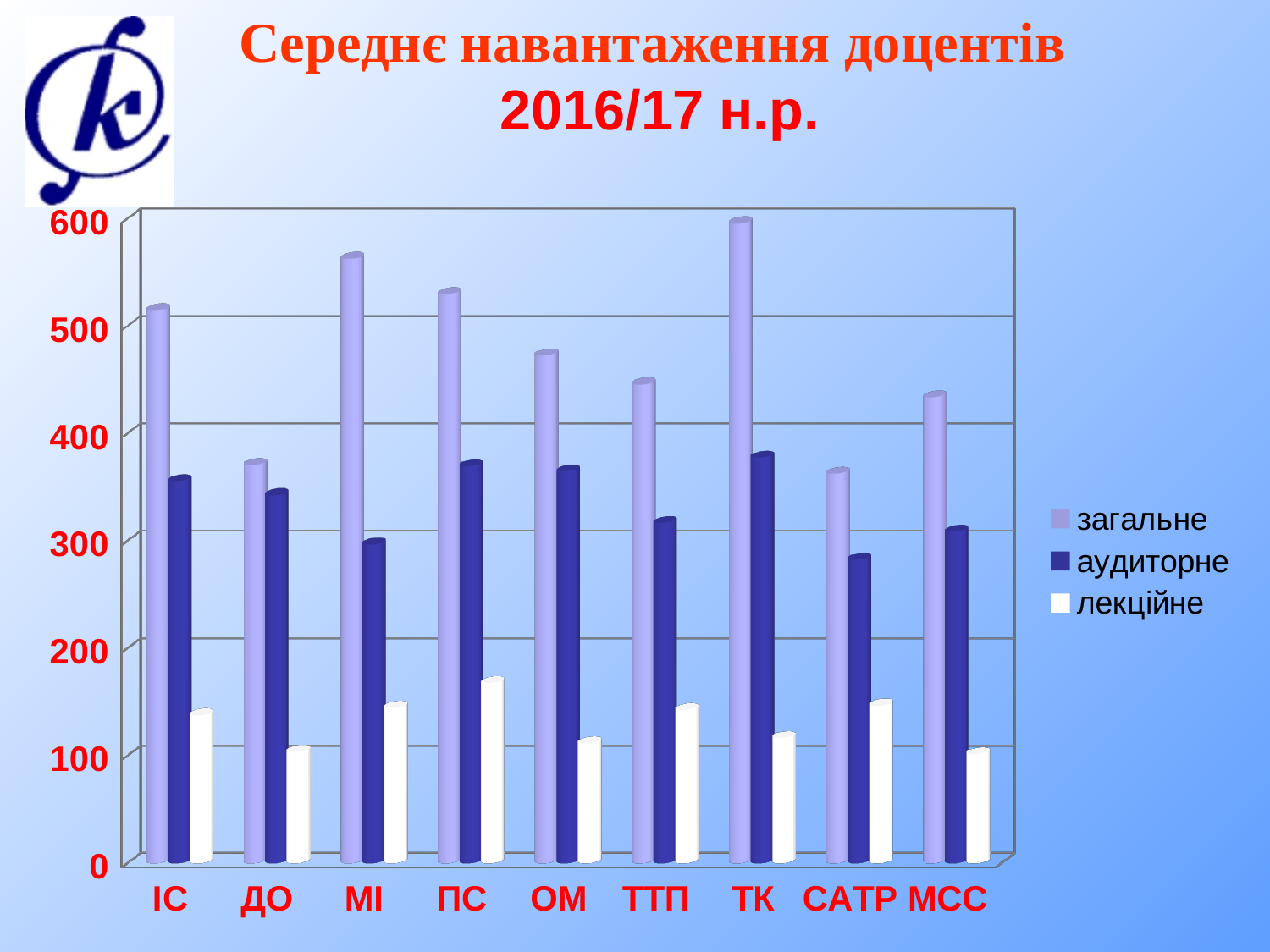
Which category has the highest value for загальне? ТК Which is larger, the загальне value for МІ or for ПС? МІ What is the title of the chart? Середнє навантаження доцентів 2016/17 н.р. How many series does the legend list? 3 Is the value for лекційне in ПС greater or less than 100? greater How many categories are shown on the x axis? 9 Is the value for аудиторне in САТР greater or less than 300? less What kind of chart is shown on the slide? bar chart Is the value for загальне in ДО greater or less than 400? less Which is larger, the загальне value for ІС or for ДО? ІС Which category has the highest value for лекційне? ПС